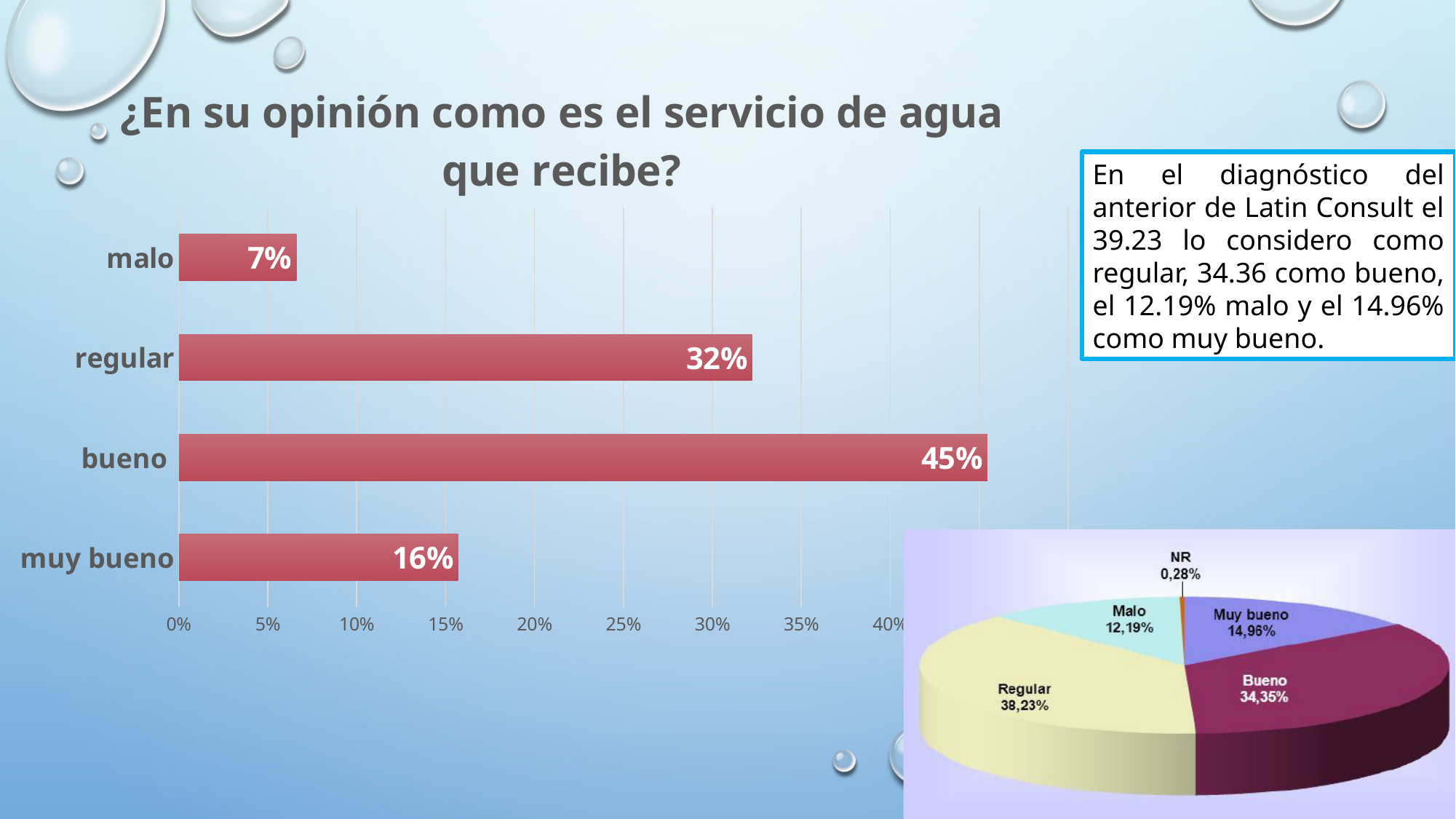
In the bar chart titled '¿En su opinión como es el servicio de agua que recibe?', what is the value for 'malo'? 7% In the pie chart at the bottom right of the slide, what is the share for 'NR'? 0,28% In the bar chart titled '¿En su opinión como es el servicio de agua que recibe?', which category has the highest value? bueno What kind of chart is the chart titled '¿En su opinión como es el servicio de agua que recibe?'? bar chart In the pie chart at the bottom right of the slide, which slice is the largest? Regular In the bar chart titled '¿En su opinión como es el servicio de agua que recibe?', which is larger, the value for 'regular' or the value for 'muy bueno'? regular In the bar chart titled '¿En su opinión como es el servicio de agua que recibe?', what is the value for 'bueno'? 45% In the bar chart titled '¿En su opinión como es el servicio de agua que recibe?', what is the value for 'muy bueno'? 16% In the bar chart titled '¿En su opinión como es el servicio de agua que recibe?', which category has the lowest value? malo How many categories are shown in the bar chart titled '¿En su opinión como es el servicio de agua que recibe?'? 4 In the bar chart titled '¿En su opinión como es el servicio de agua que recibe?', what is the difference between the values for 'bueno' and 'regular'? 13% In the pie chart at the bottom right of the slide, what is the share for 'Regular'? 38,23%